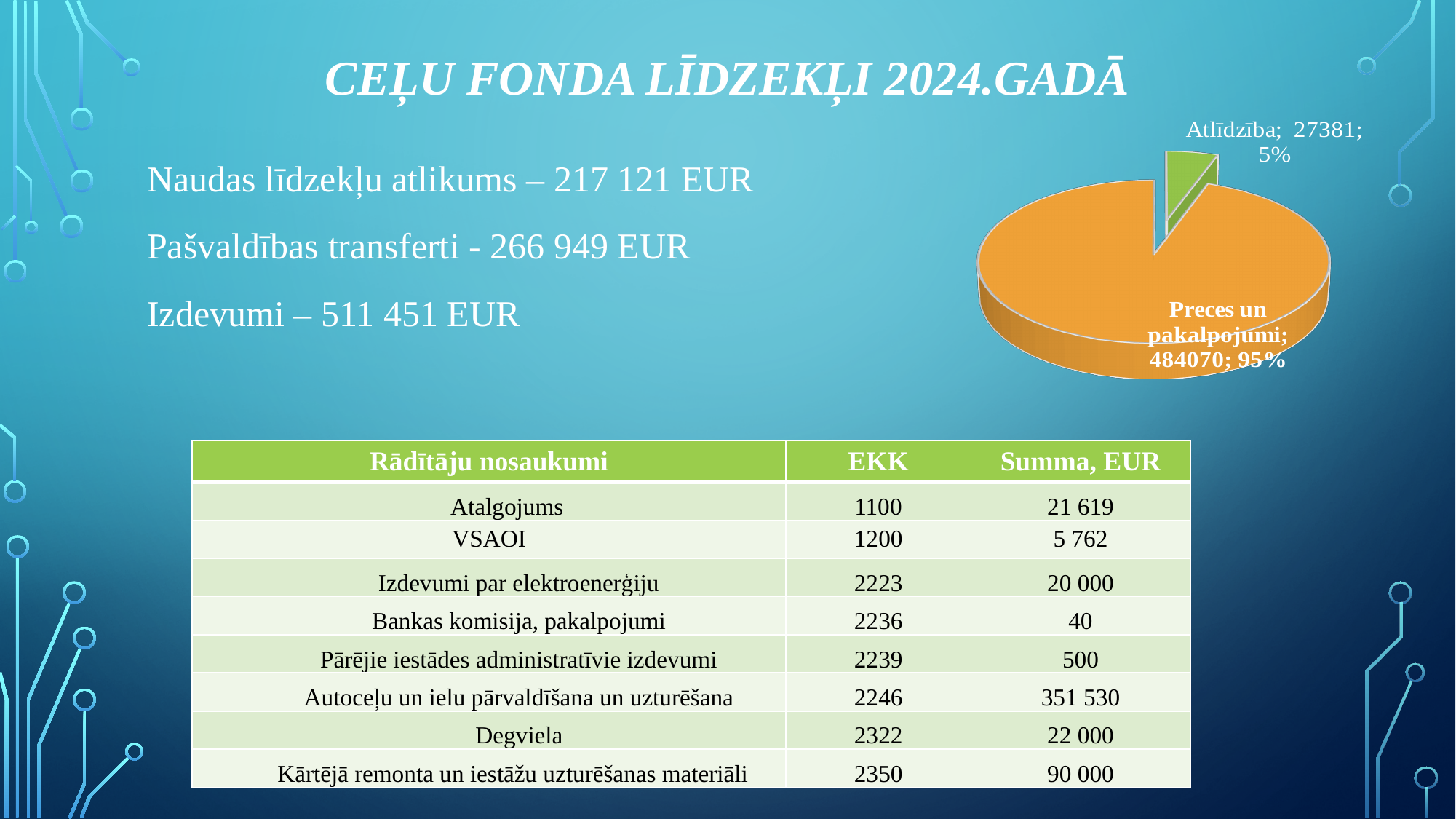
Which is larger in the pie chart, Atlīdzība or Preces un pakalpojumi? Preces un pakalpojumi What is the value for Preces un pakalpojumi in the pie chart? 484070 What share of the pie does Atlīdzība represent? 5% Which slice of the pie chart is the largest? Preces un pakalpojumi What is the total of the two slices in the pie chart? 511451 What is the difference between the values for Preces un pakalpojumi and Atlīdzība in the pie chart? 456689 What colour is the Atlīdzība slice in the pie chart? green Which slice of the pie chart is the smallest? Atlīdzība What kind of chart is shown on the slide? pie chart What is the value for Atlīdzība in the pie chart? 27381 How many slices does the pie chart have? 2 What share of the pie does Preces un pakalpojumi represent? 95%